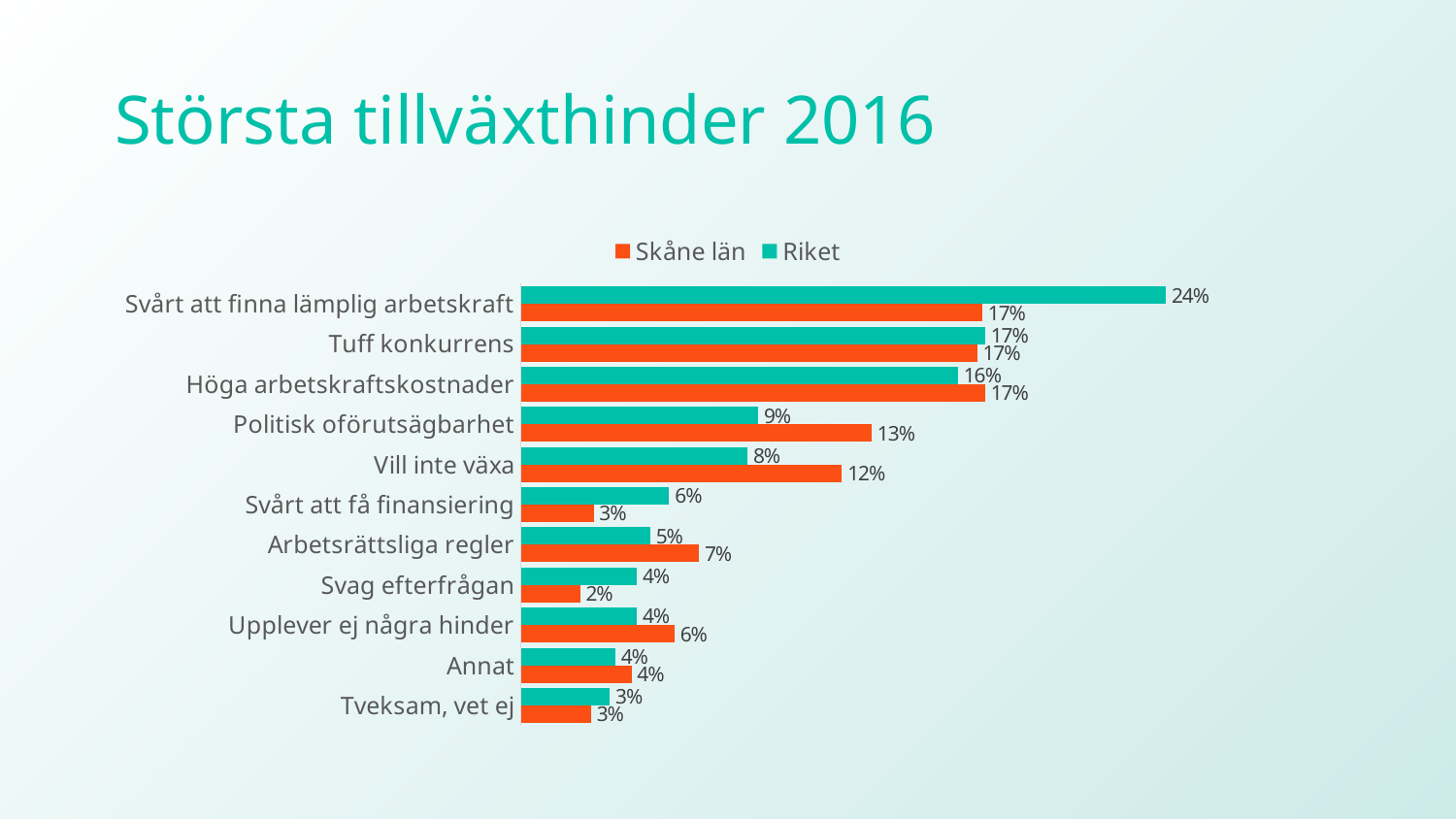
What is the difference between the Skåne län and Riket values for Arbetsrättsliga regler? 2% What is the Skåne län value for Politisk oförutsägbarhet? 13% Which category has the lowest Skåne län value? Svag efterfrågan What type of chart is shown on the slide? Bar chart What is the Riket value for Svårt att få finansiering? 6% What is the Skåne län value for Vill inte växa? 12% What is the difference between the Riket and Skåne län values for Svårt att finna lämplig arbetskraft? 7% How many series does the legend list? 2 What is the Riket value for Svårt att finna lämplig arbetskraft? 24% Which category has the highest Riket value? Svårt att finna lämplig arbetskraft How many categories are shown in the chart? 11 For Vill inte växa, which series has the larger value, Skåne län or Riket? Skåne län